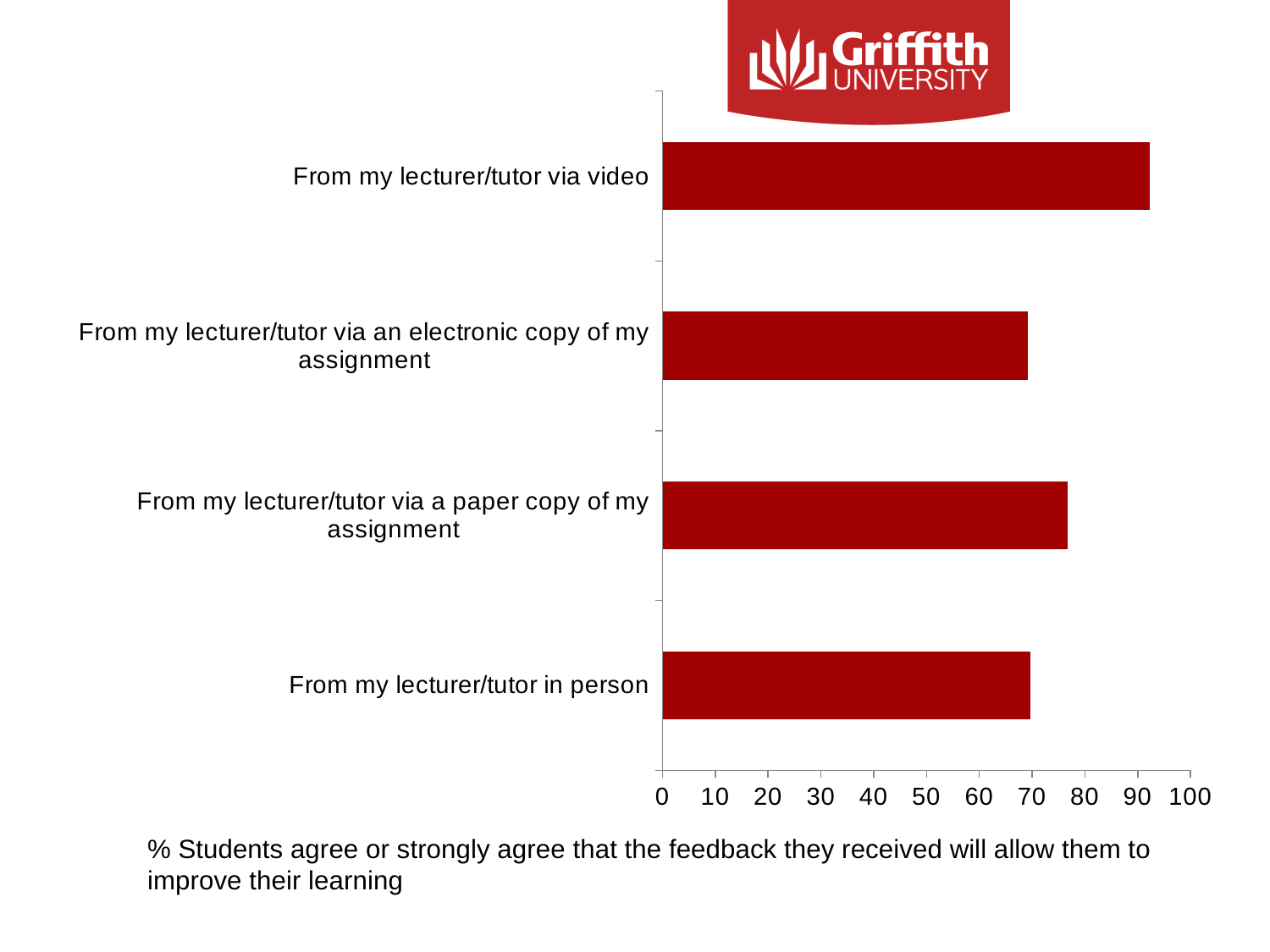
Is the value for "From my lecturer/tutor via video" greater or less than 80? greater Which is larger: the value for "From my lecturer/tutor via video" or the value for "From my lecturer/tutor via a paper copy of my assignment"? From my lecturer/tutor via video Is the value for "From my lecturer/tutor via a paper copy of my assignment" greater or less than 70? greater Is the value for "From my lecturer/tutor via a paper copy of my assignment" greater or less than 80? less Which category has the highest value in the chart? From my lecturer/tutor via video What is the maximum value shown on the horizontal axis of the chart? 100 What kind of chart is shown on the slide? bar chart What does the caption below the chart say the values represent? % Students agree or strongly agree that the feedback they received will allow them to improve their learning Which is larger: the value for "From my lecturer/tutor via a paper copy of my assignment" or the value for "From my lecturer/tutor in person"? From my lecturer/tutor via a paper copy of my assignment How many categories are plotted in the chart? 4